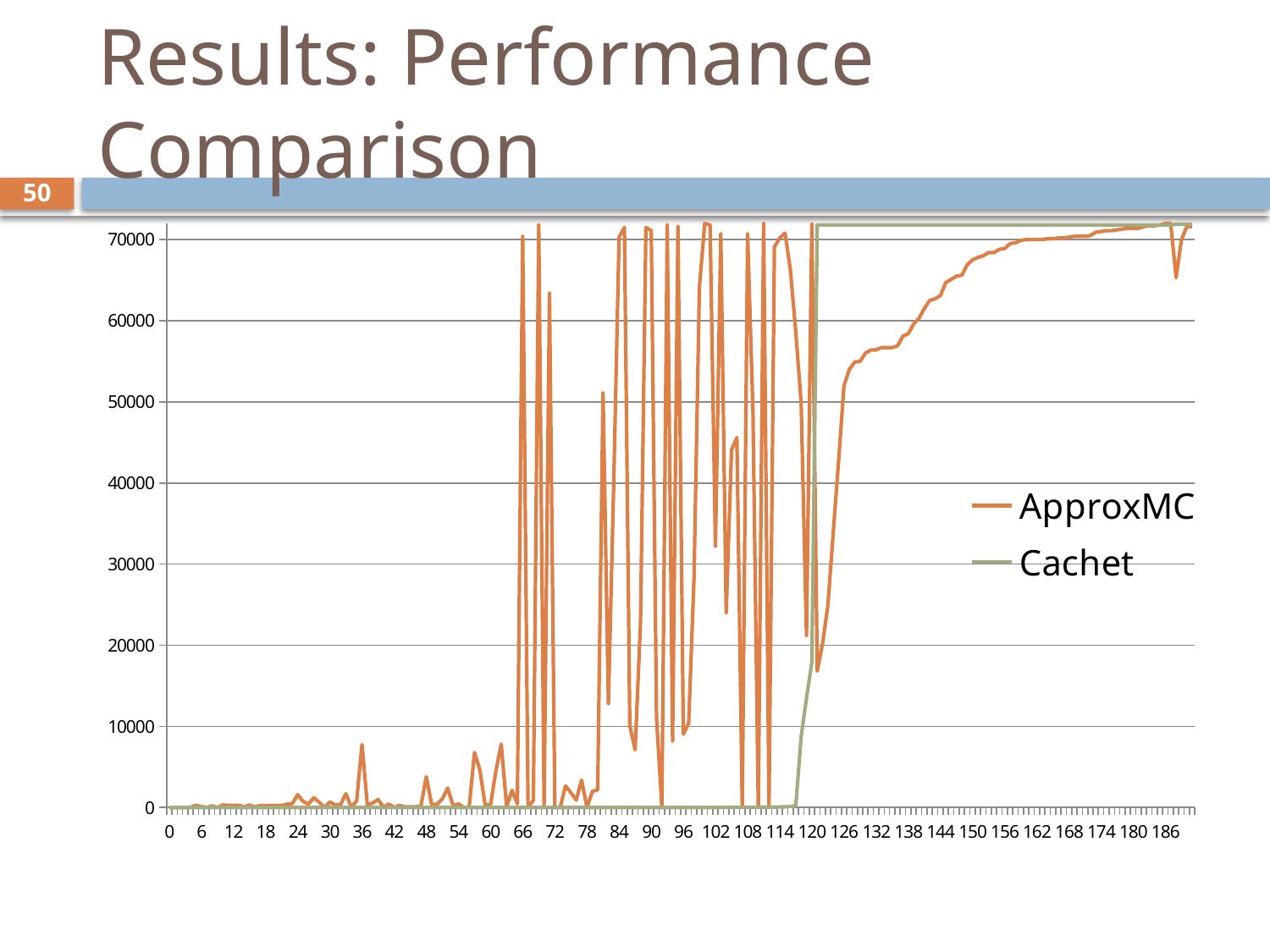
How many series does the legend list? 2 Is the Cachet value at x = 60 greater or less than 10000? less Does the Cachet line rise or fall overall from left to right along the x axis? rise At x = 144, which series has the higher value, ApproxMC or Cachet? Cachet What colour is the ApproxMC line? orange Is the Cachet value at x = 150 greater or less than 60000? greater Is the ApproxMC value at x = 12 greater or less than 10000? less What is the highest value labelled on the y axis? 70000 Which two series are listed in the chart legend? ApproxMC and Cachet What kind of chart is shown on the slide? line chart